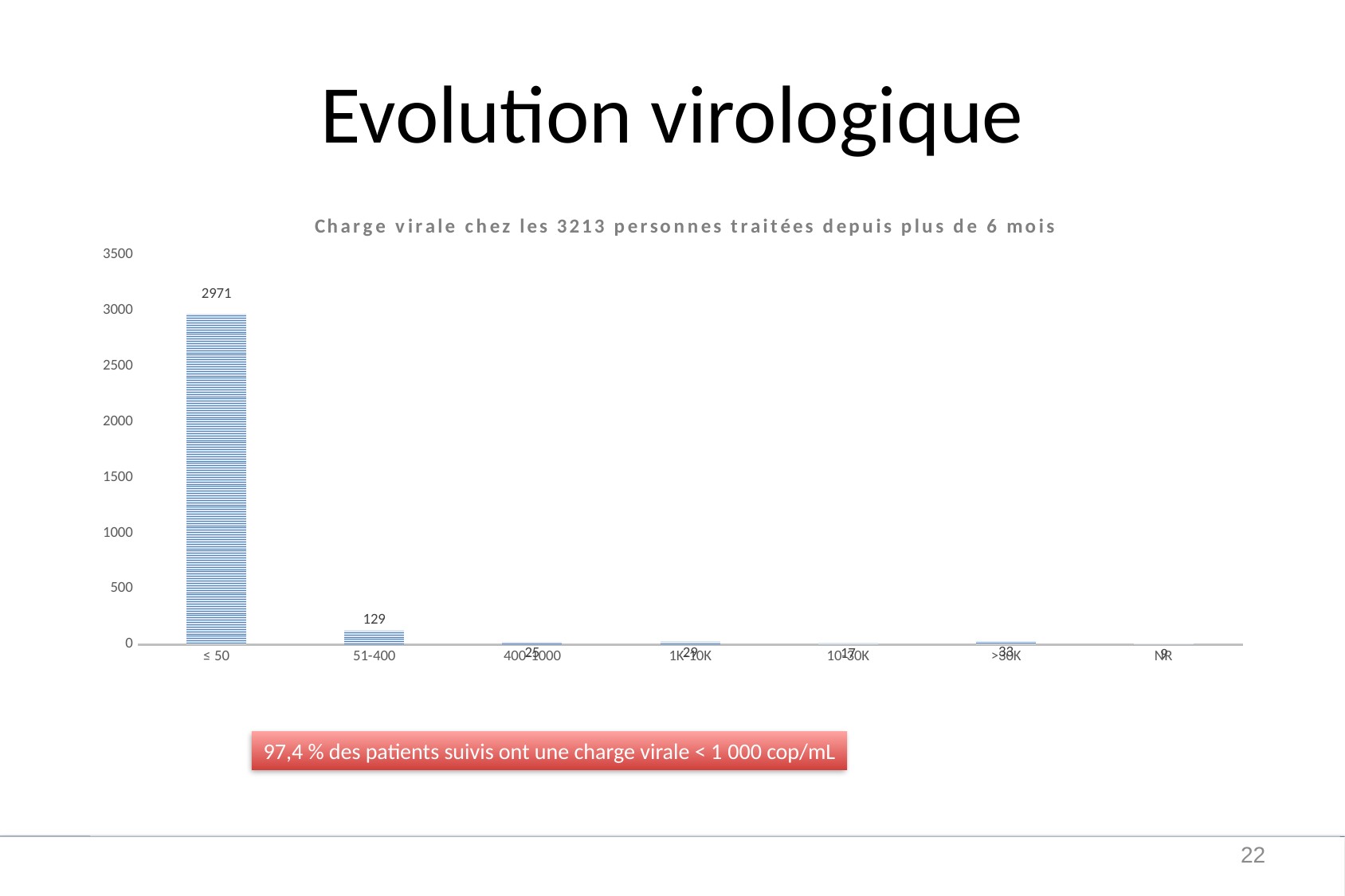
Is the value for ≤ 50 greater or less than 2500? greater What is the title of the chart? Charge virale chez les 3213 personnes traitées depuis plus de 6 mois What type of chart is shown on the slide? bar chart How many categories are shown on the x axis of the chart? 7 Is the value for 51-400 greater or less than 500? less Which category has the highest value? ≤ 50 What is the value for the ≤ 50 category? 2971 What is the value for the 51-400 category? 129 What is the difference between the values for ≤ 50 and 51-400? 2842 What percentage of followed patients have a viral load below 1 000 cop/mL according to the text box on the slide? 97,4 % Which is larger, the value for ≤ 50 or the value for 51-400? ≤ 50